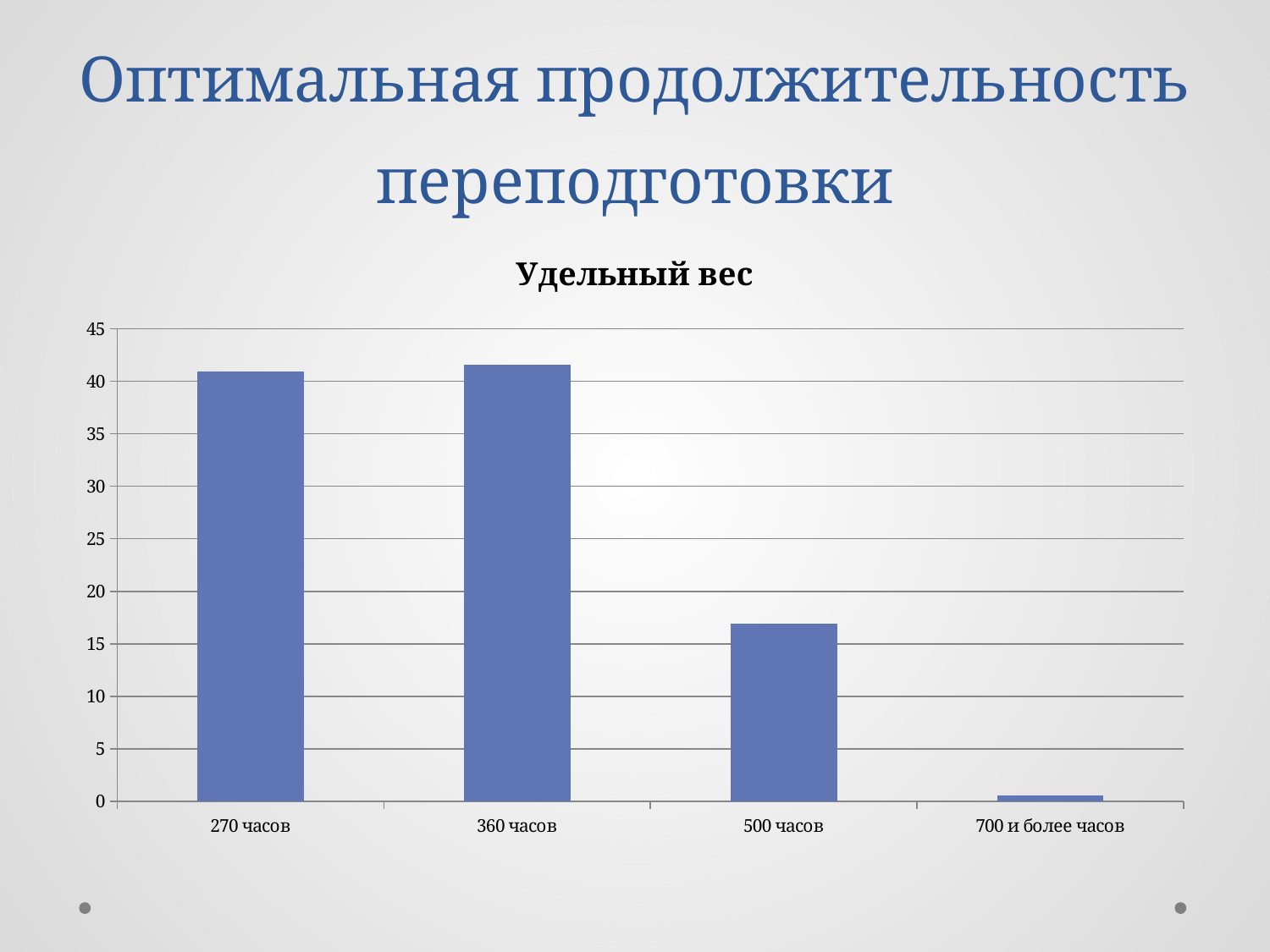
What is the title of the chart? Удельный вес Which category has the lowest value in the chart? 700 и более часов What is the label of the last category on the x axis? 700 и более часов Is the value for 500 часов greater or less than 15? greater Which is larger, the value for 500 часов or the value for 700 и более часов? 500 часов Is the value for 270 часов greater or less than 40? greater Is the value for 700 и более часов greater or less than 5? less Which is larger, the value for 270 часов or the value for 500 часов? 270 часов What kind of chart is shown on the slide? bar chart How many categories are shown on the x axis of the chart? 4